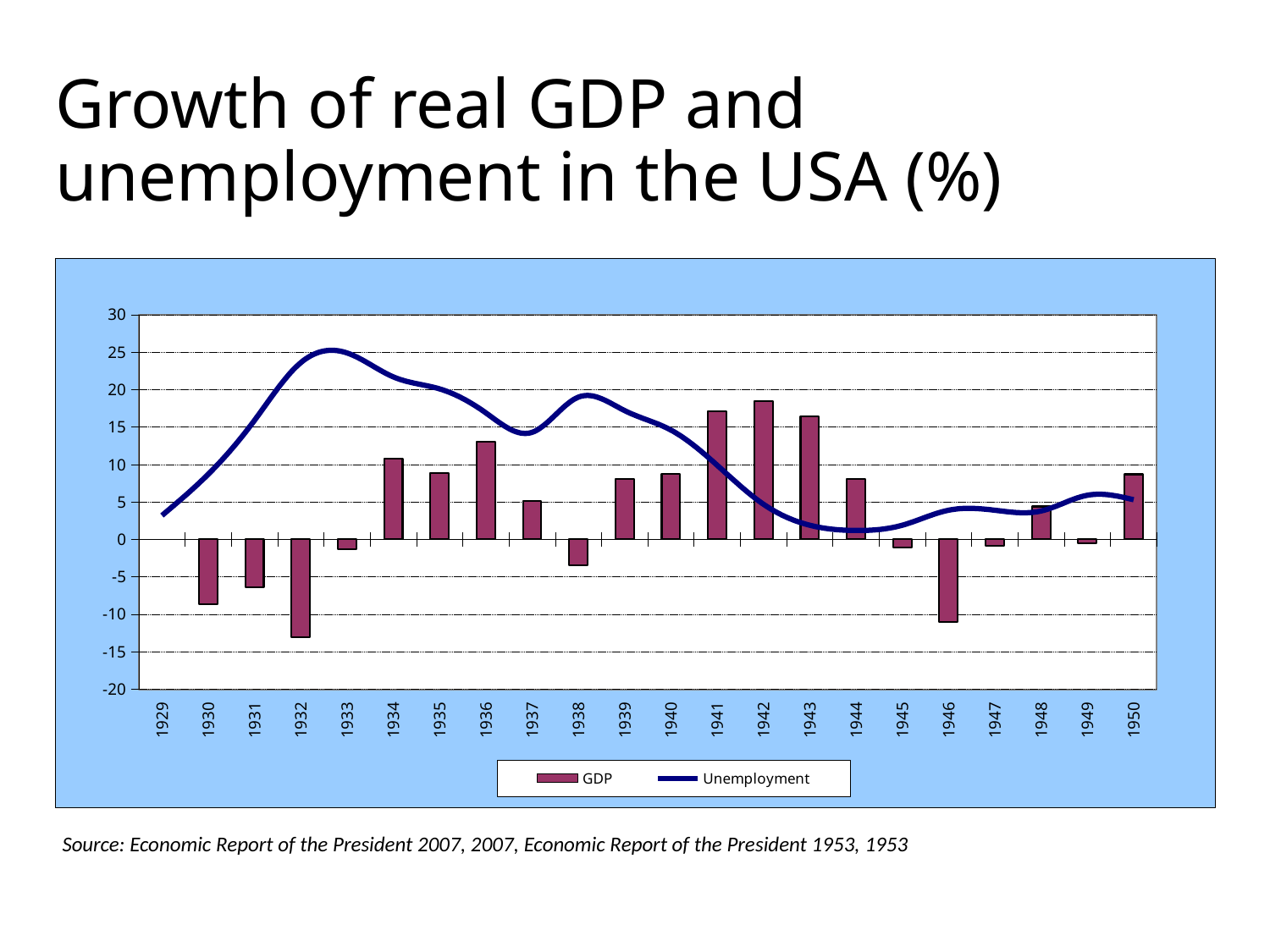
In which year is the GDP bar the highest? 1942 Is the GDP value for 1932 greater or less than -10? less How many series does the legend list? 2 Which two series are listed in the legend? GDP and Unemployment What kind of chart is shown on the slide? A combined bar and line chart Does the Unemployment line rise or fall overall from 1933 to 1944? fall How many years are shown on the x axis? 22 Which year has the larger GDP bar, 1934 or 1935? 1934 In which year does the Unemployment line reach its peak? 1933 Is the GDP value for 1942 greater or less than 15? greater Is the Unemployment value for 1933 greater or less than 20? greater In which year is the GDP bar the lowest? 1932